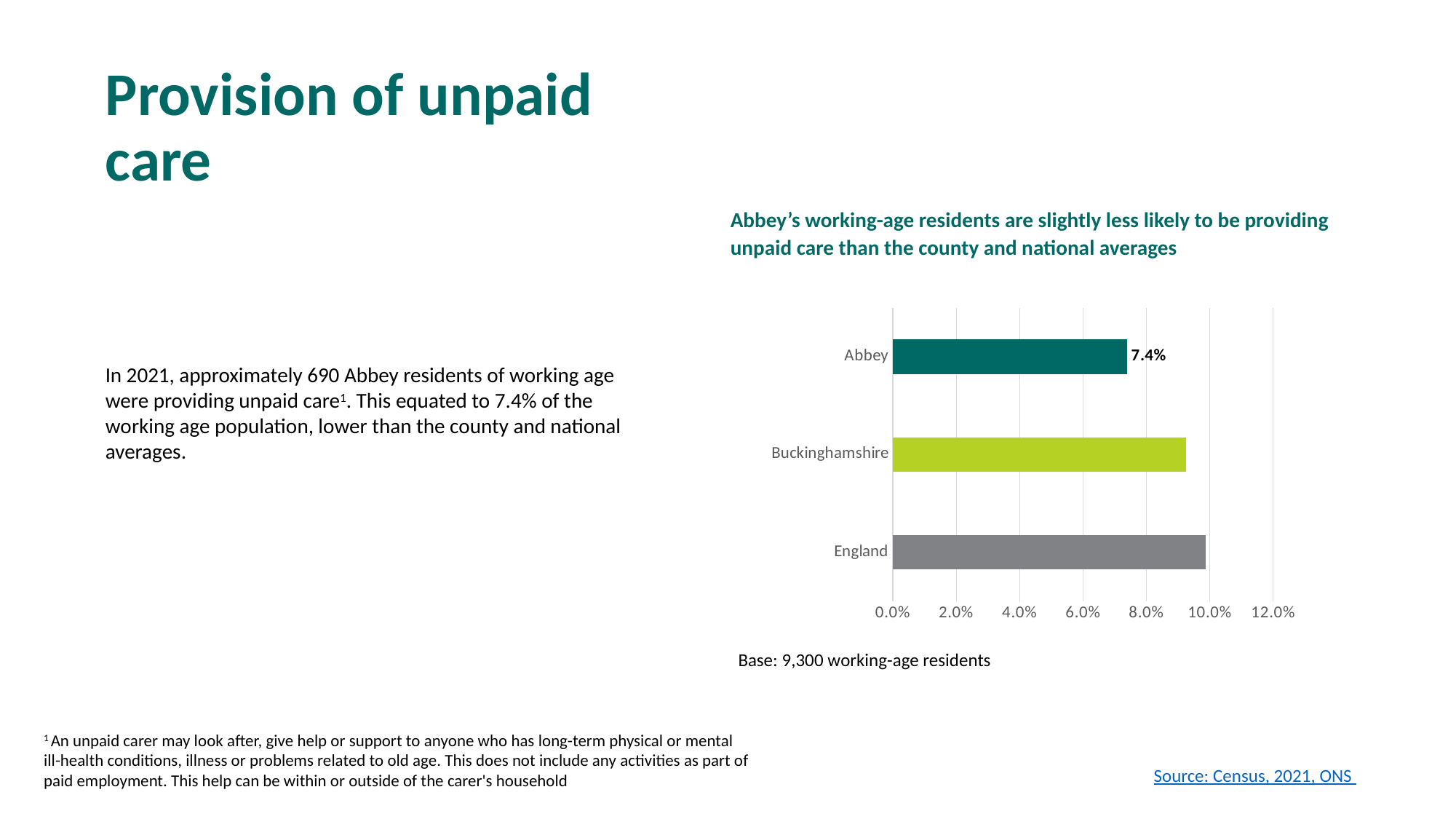
Is the value for Abbey greater or less than 8.0%? less Which category has the highest value in the chart? England What is the highest value shown on the chart's x axis? 12.0% How many categories are shown in the chart? 3 Which has a larger value, Abbey or England? England What kind of chart is shown on the slide? Bar chart Which category has the lowest value in the chart? Abbey What is the base stated below the chart? 9,300 working-age residents Is the value for Buckinghamshire greater or less than 8.0%? greater What is the value for Abbey in the chart? 7.4% Which has a larger value, Abbey or Buckinghamshire? Buckinghamshire Is the value for England greater or less than 8.0%? greater